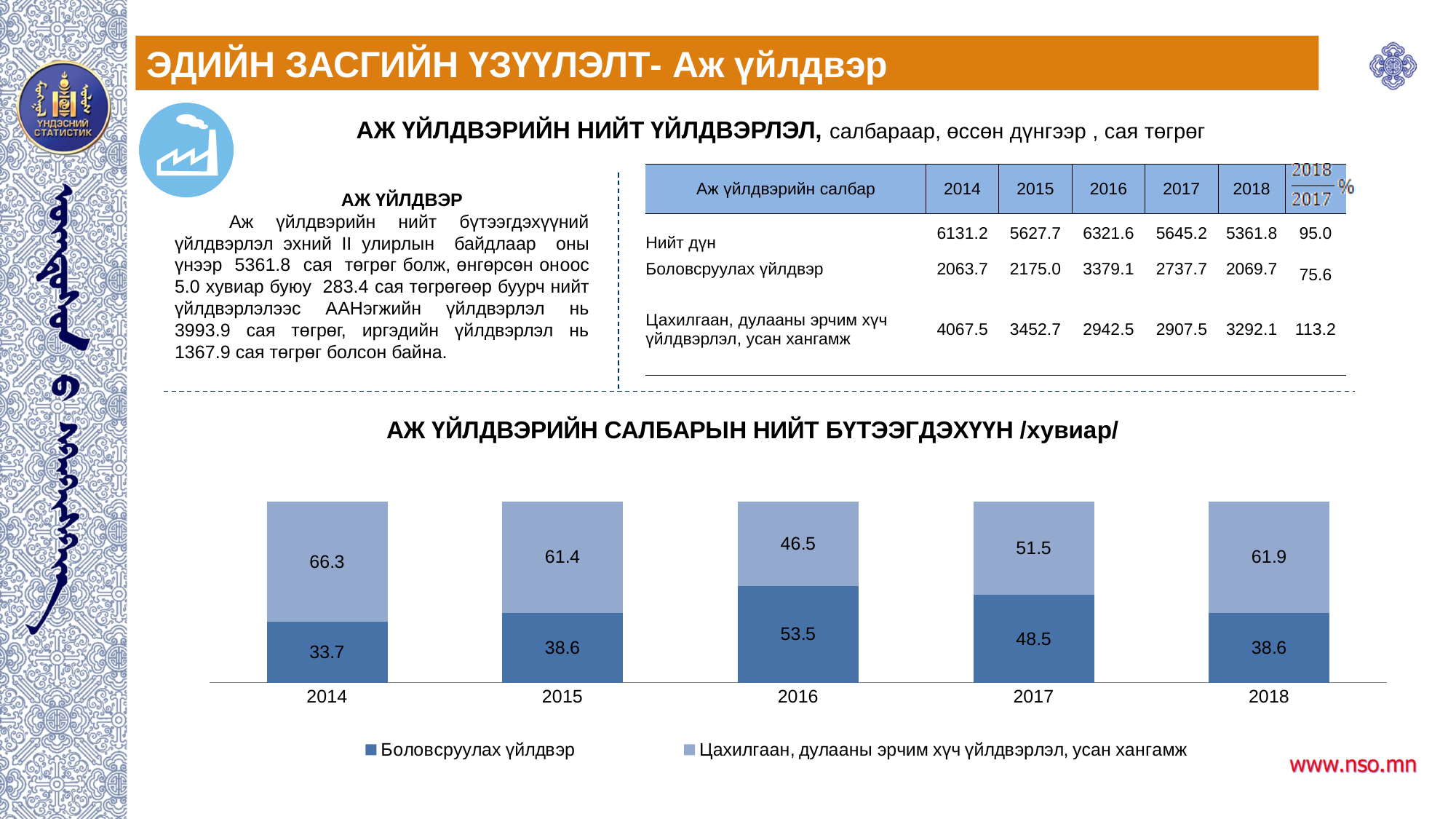
What is the difference between the Цахилгаан, дулааны эрчим хүч үйлдвэрлэл, усан хангамж value and the Боловсруулах үйлдвэр value in 2014? 32.6 What is the total of the stacked bar for 2018? 100.0 How many years are shown on the x axis of the chart? 5 In which year is the value for Боловсруулах үйлдвэр highest? 2016 In which year is the value for Цахилгаан, дулааны эрчим хүч үйлдвэрлэл, усан хангамж lowest? 2016 What type of chart is shown on the slide? stacked bar chart What is the value for Боловсруулах үйлдвэр in 2016? 53.5 What is the value for Боловсруулах үйлдвэр in 2018? 38.6 What is the value for Цахилгаан, дулааны эрчим хүч үйлдвэрлэл, усан хангамж in 2014? 66.3 Does the value for Боловсруулах үйлдвэр rise or fall from 2016 to 2018? fall How many series does the chart legend list? 2 Which is larger in 2017: Боловсруулах үйлдвэр or Цахилгаан, дулааны эрчим хүч үйлдвэрлэл, усан хангамж? Цахилгаан, дулааны эрчим хүч үйлдвэрлэл, усан хангамж